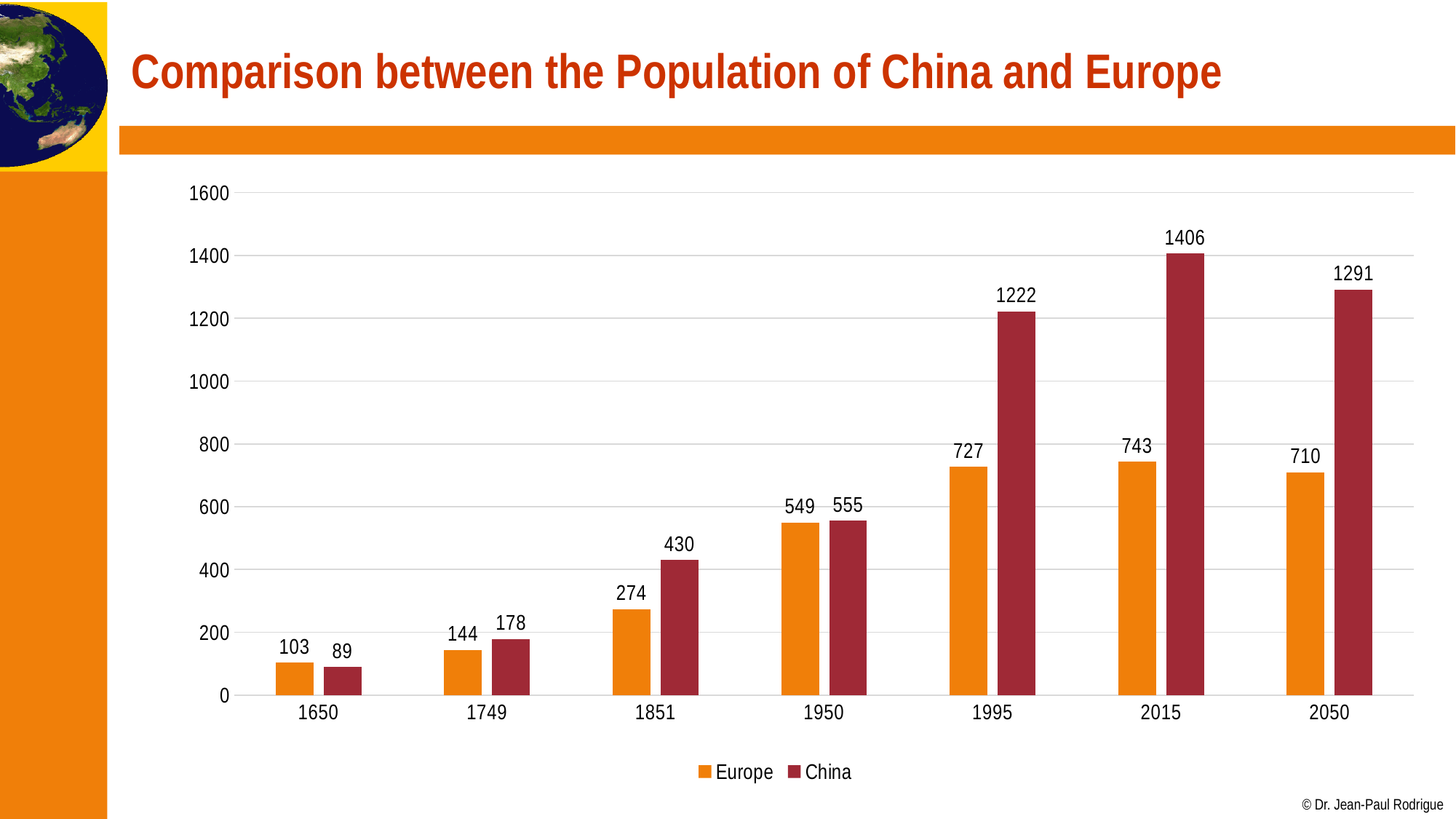
What is the title of the slide? Comparison between the Population of China and Europe What is the difference between China and Europe in 1995? 495 Is the value for China in 2050 greater or less than 1200? greater Which is larger in 1650, Europe or China? Europe In which year is the Europe series lowest? 1650 What is the value for China in 2015? 1406 What kind of chart is shown? bar chart How many years are shown on the x axis? 7 In which year is the China series highest? 2015 What is the value for Europe in 1650? 103 How many series does the legend list? 2 What is the value for China in 1851? 430